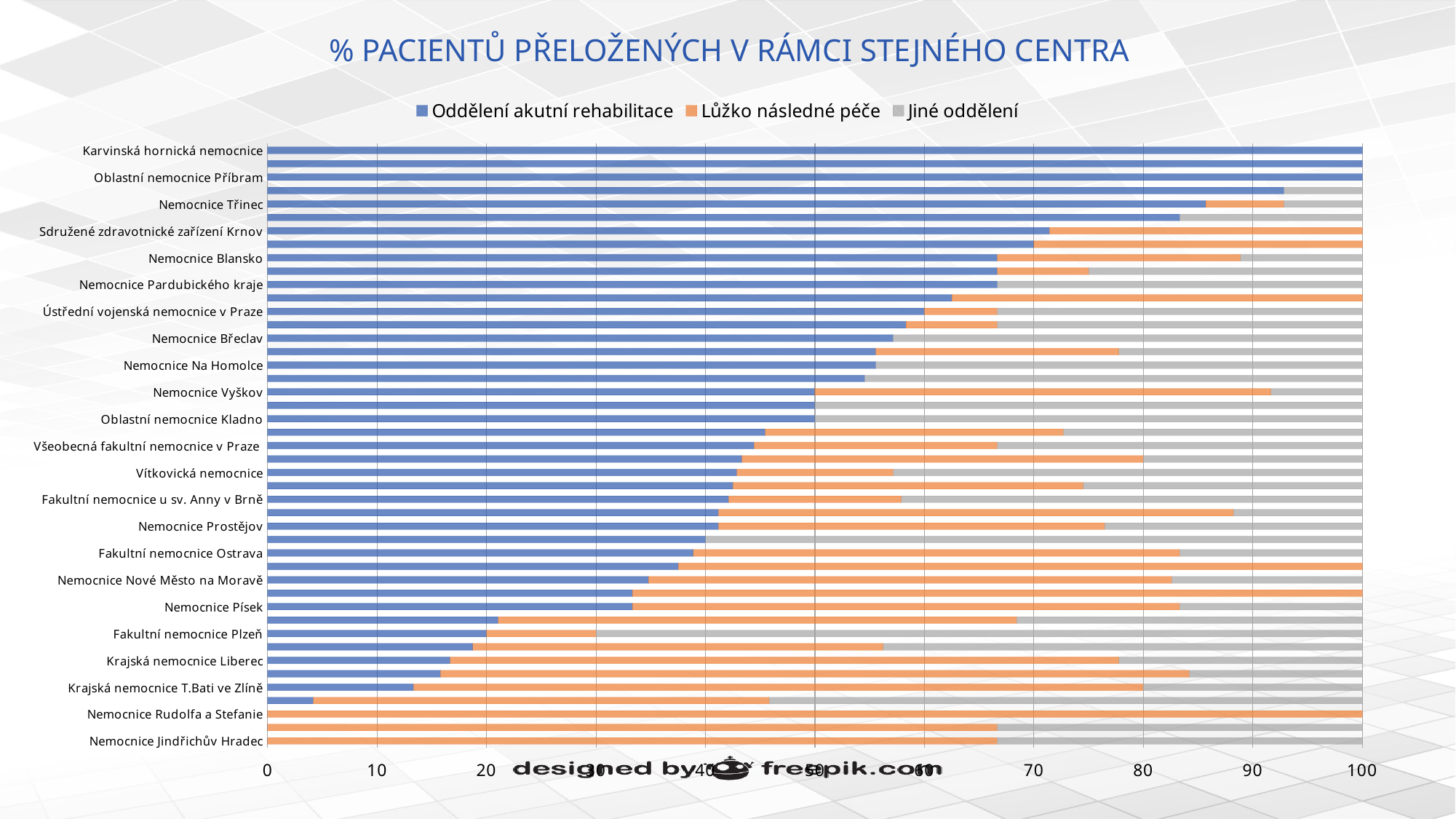
Is the value of Oddělení akutní rehabilitace for Nemocnice Vyškov greater or less than 40? greater What is the title of the chart? % PACIENTŮ PŘELOŽENÝCH V RÁMCI STEJNÉHO CENTRA What kind of chart is shown on the slide? Stacked horizontal bar chart Is the value of Oddělení akutní rehabilitace for Karvinská hornická nemocnice greater or less than 90? greater Which has a larger Oddělení akutní rehabilitace value, Nemocnice Třinec or Fakultní nemocnice Plzeň? Nemocnice Třinec Which legend entry is shown in orange? Lůžko následné péče Is the value of Oddělení akutní rehabilitace for Fakultní nemocnice Plzeň greater or less than 30? less Going from the top of the chart to the bottom, do the Oddělení akutní rehabilitace bars get longer or shorter? shorter How many series does the legend list? 3 Which has a larger Oddělení akutní rehabilitace value, Krajská nemocnice Liberec or Nemocnice Blansko? Nemocnice Blansko